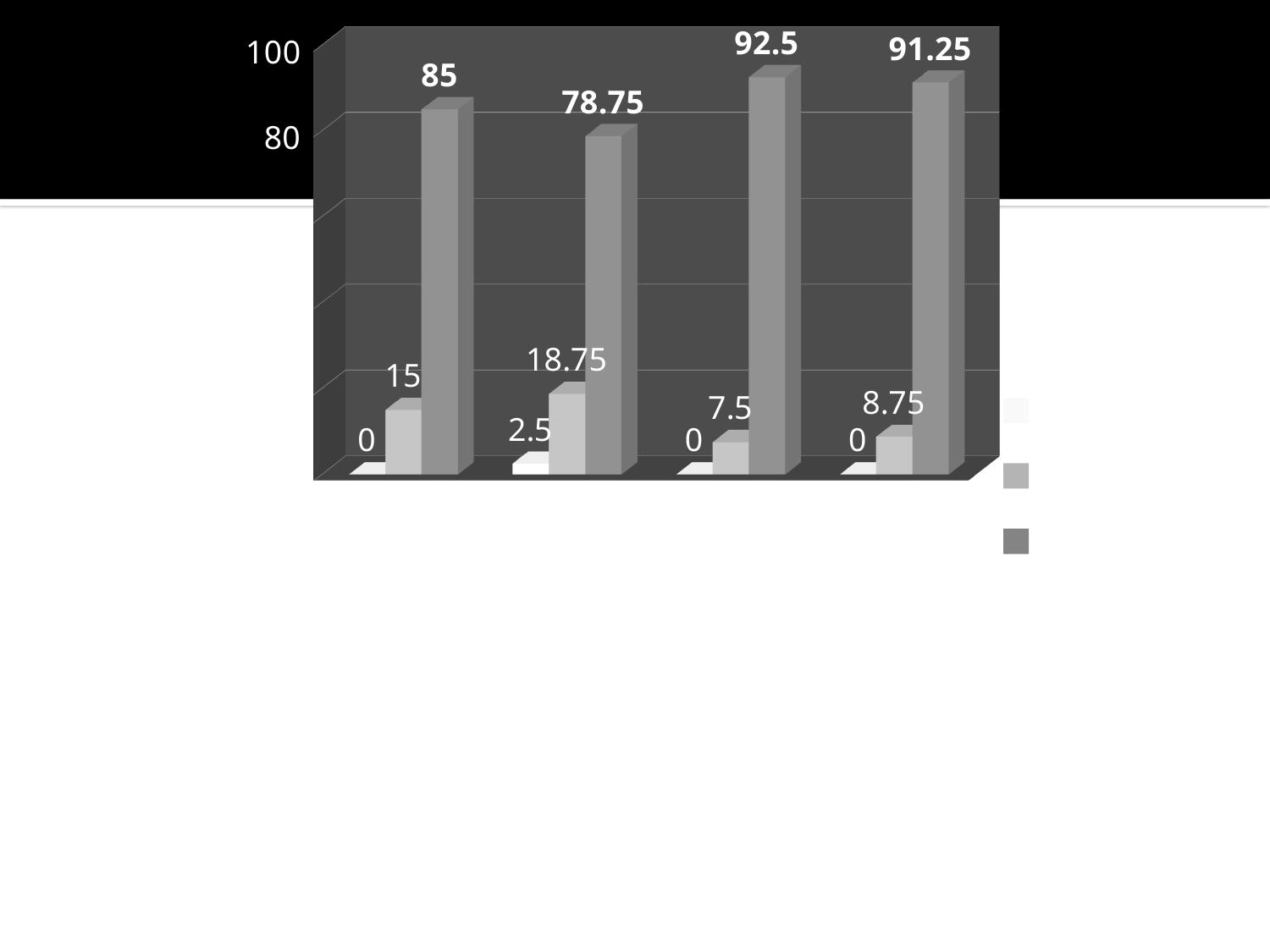
What is the total of the three bars in the third group from the left? 100 How many groups of bars are plotted along the x axis? 4 What is the difference between the dark grey bar in the third group (92.5) and the dark grey bar in the first group (85)? 7.5 Which group has the lowest dark grey bar? the second group from the left (78.75) What is the value of the white bar in the second group from the left? 2.5 What kind of chart is shown on the slide? bar chart What is the difference between the light grey bar in the second group (18.75) and the light grey bar in the first group (15)? 3.75 Which is larger: the light grey bar in the first group or the light grey bar in the fourth group? the first group (15) What is the value of the dark grey bar in the first (leftmost) group? 85 Which group has the highest dark grey bar? the third group from the left (92.5) What is the value of the light grey bar in the second group from the left? 18.75 How many series does the legend list? 3